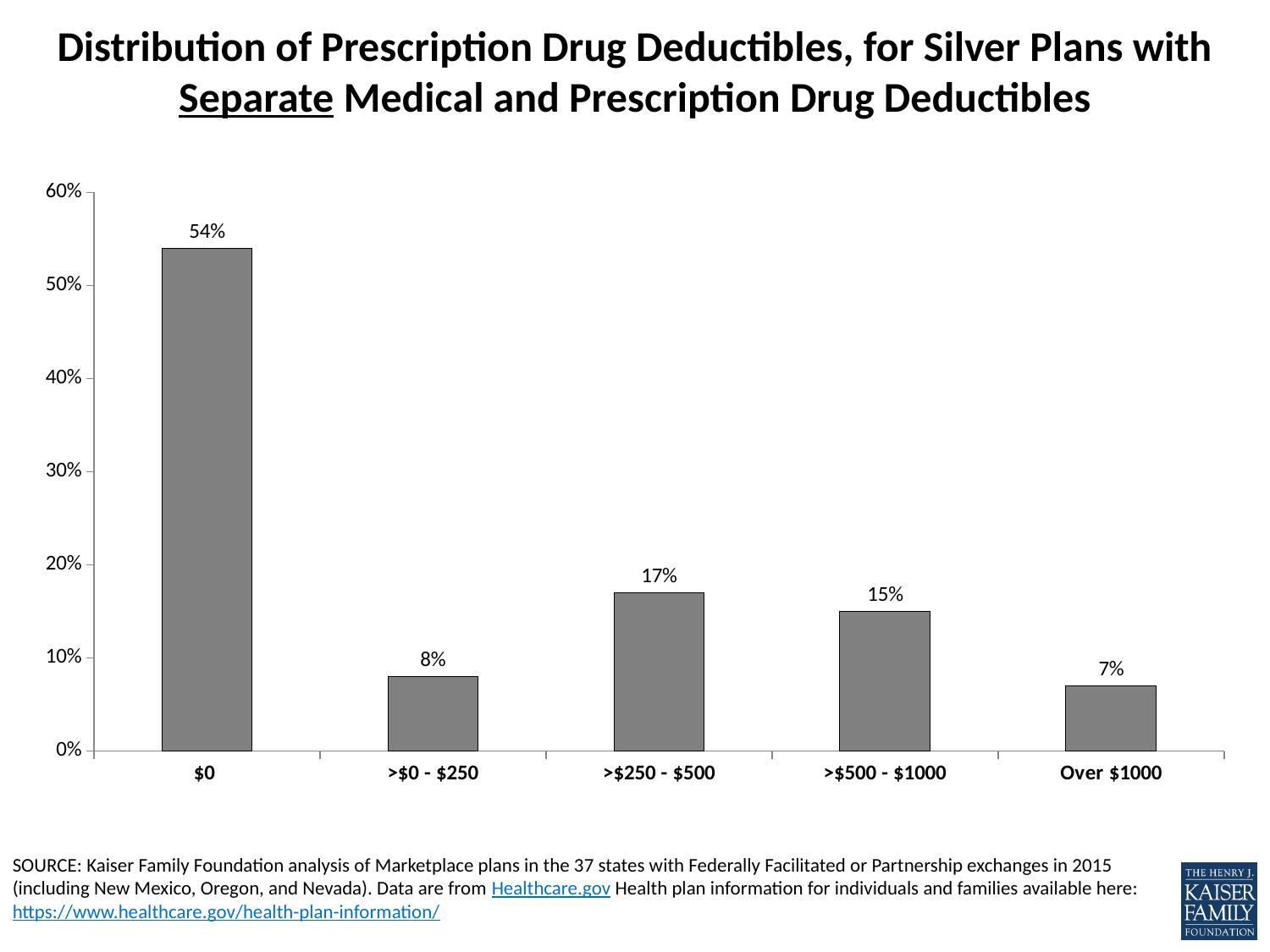
Which deductible category has the lowest share of plans? Over $1000 What is the difference between the $0 category and the >$0 - $250 category? 46 percentage points How many deductible categories are shown on the x axis? 5 Which deductible category has the highest share of plans? $0 Is the value for the $0 category greater or less than 50%? greater What is the value for the Over $1000 category? 7% What percentage of plans have a $0 prescription drug deductible? 54% What is the maximum value shown on the y axis? 60% Which is larger, the value for >$0 - $250 or the value for >$500 - $1000? >$500 - $1000 What is the value for the >$250 - $500 category? 17% What is the difference between the >$250 - $500 and >$500 - $1000 categories? 2 percentage points What kind of chart is shown on the slide? Bar chart